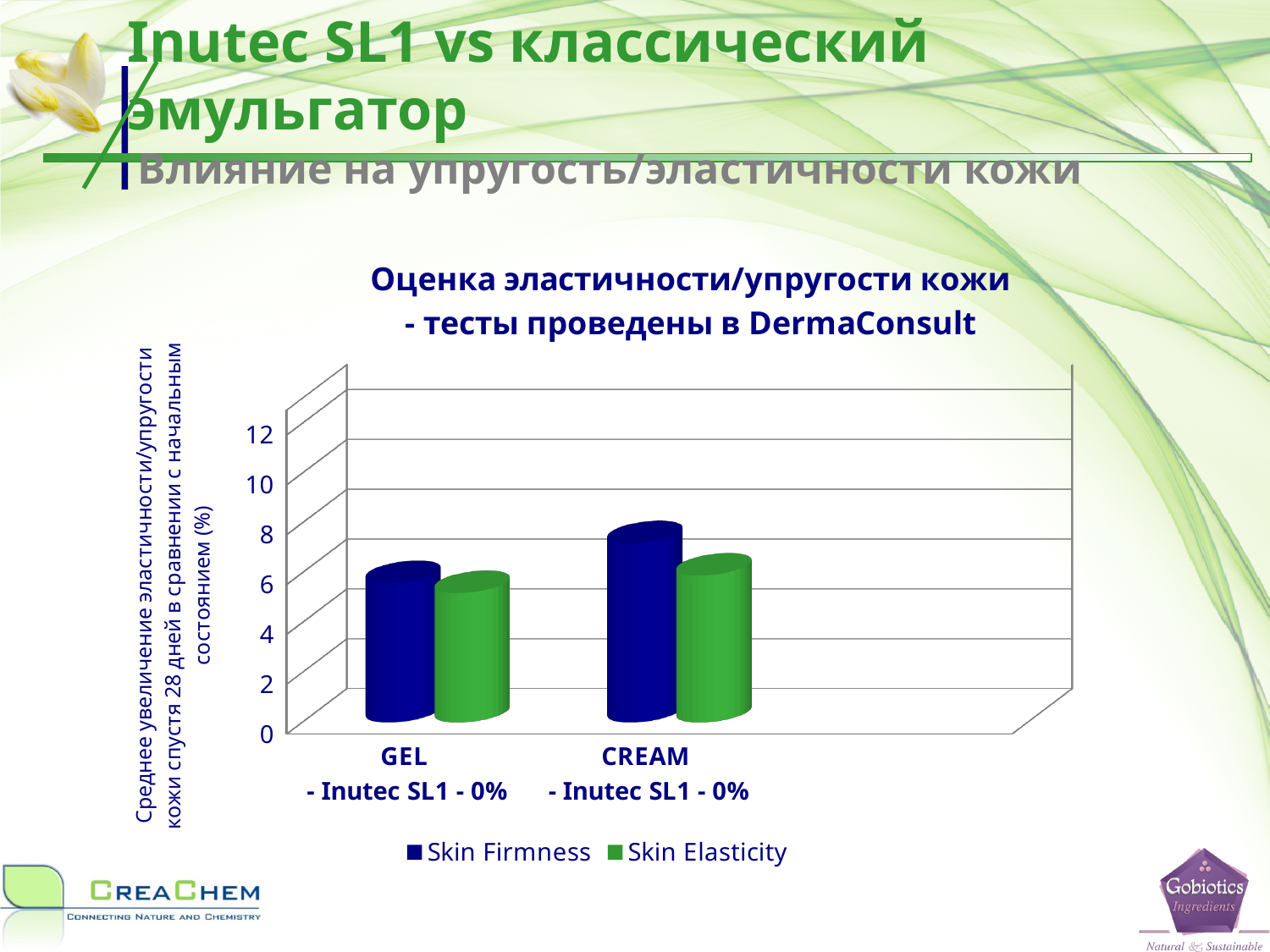
Is the Skin Elasticity value for GEL greater or less than 8? less Is the Skin Firmness value for GEL greater or less than 10? less Which series are listed in the chart legend? Skin Firmness and Skin Elasticity How many categories are shown on the x axis of the chart? 2 What kind of chart is shown on the slide? bar chart What colour represents Skin Elasticity in the chart? green Is the Skin Elasticity value for CREAM greater or less than 4? greater Which category has the highest Skin Elasticity value? CREAM For CREAM, which is larger: Skin Firmness or Skin Elasticity? Skin Firmness How many series does the chart legend list? 2 Which category has the higher Skin Firmness value, GEL or CREAM? CREAM